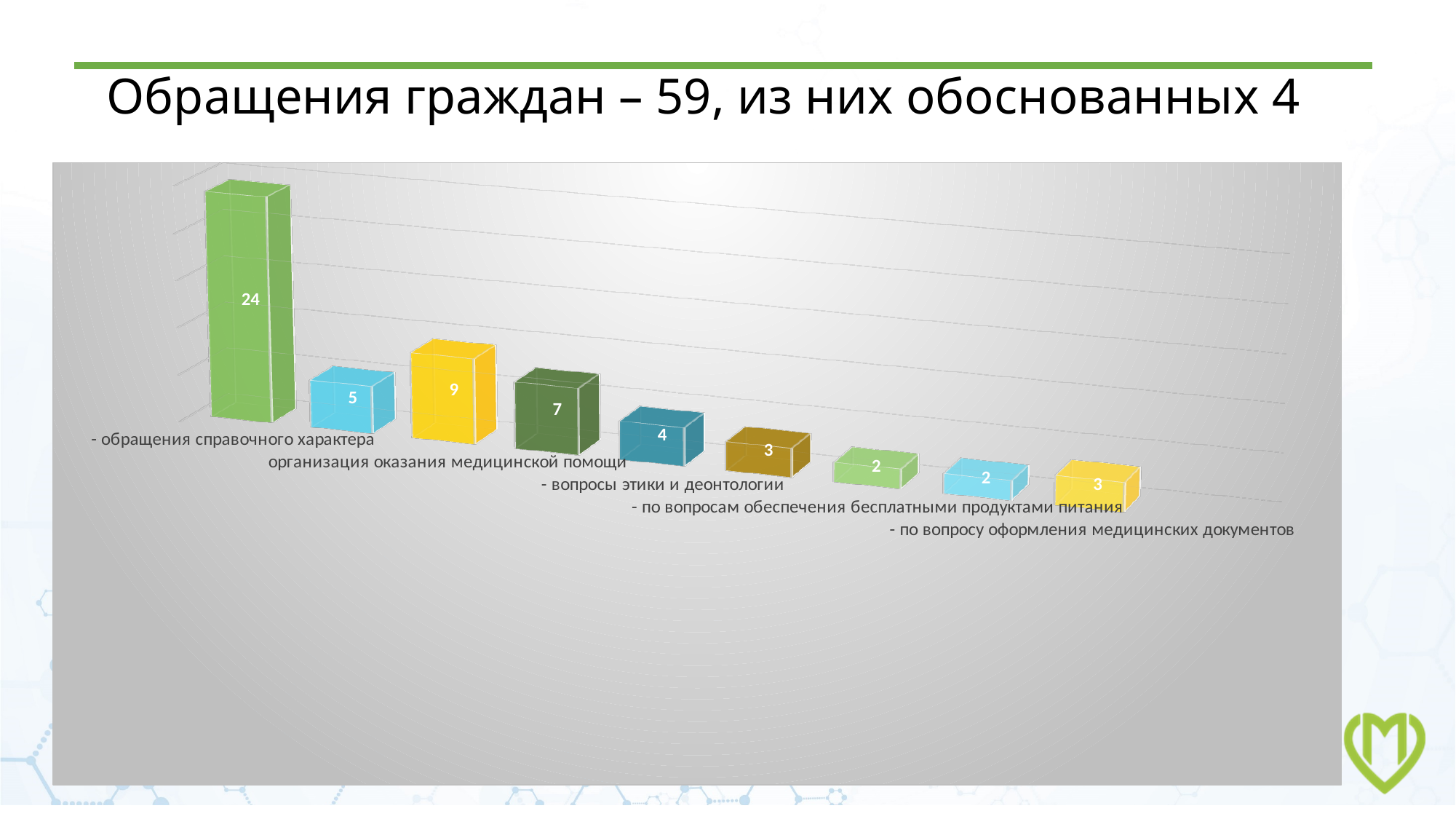
What is the lowest value shown in the chart? 2 What is the value of the fifth bar from the left? 4 How many bars have the value 2? 2 What is the value of the bar labelled "обращения справочного характера"? 24 What is the sum of all the bar values in the chart? 59 How many bars are plotted in the chart? 9 What is the difference between the first bar (24) and the third bar (9)? 15 What is the title of the slide? Обращения граждан – 59, из них обоснованных 4 What is the highest value shown in the chart? 24 What kind of chart is shown on the slide? bar chart Which is larger: the second bar from the left or the fourth bar from the left? the fourth bar (7) What is the value of the third bar from the left? 9